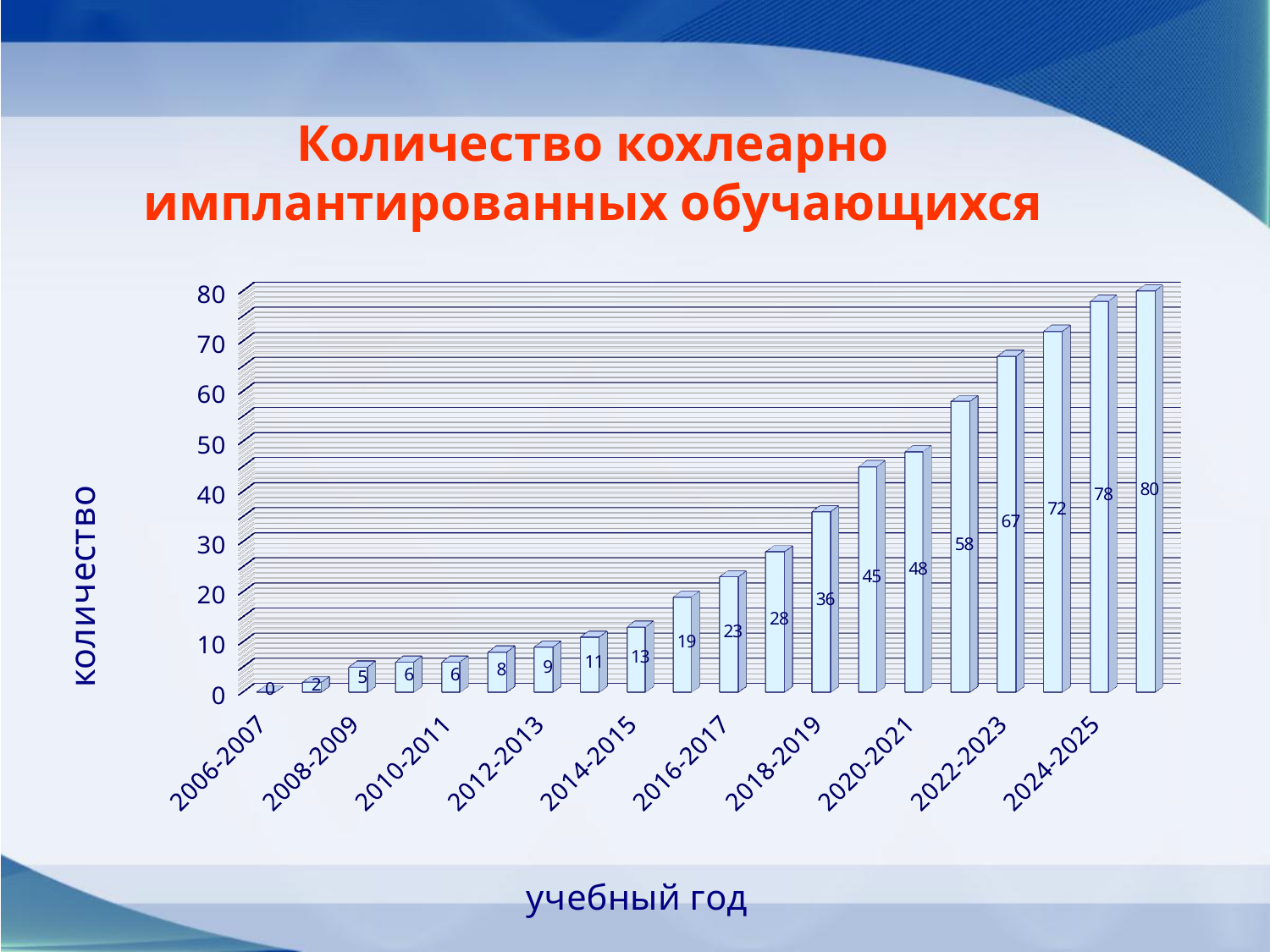
What is the highest value shown on the chart? 80 What is the label of the vertical axis? количество Which is larger, the value for 2016-2017 or the value for 2014-2015? 2016-2017 Do the values generally rise or fall from left to right along the x axis? rise What is the value for the 2006-2007 academic year? 0 How many bars are plotted on the chart? 20 What is the value for the 2012-2013 academic year? 9 What type of chart is shown on the slide? bar chart What is the difference between the values for 2022-2023 and 2020-2021? 19 Which academic year has the lowest value? 2006-2007 What is the value for the 2018-2019 academic year? 36 What is the value for the 2024-2025 academic year? 78